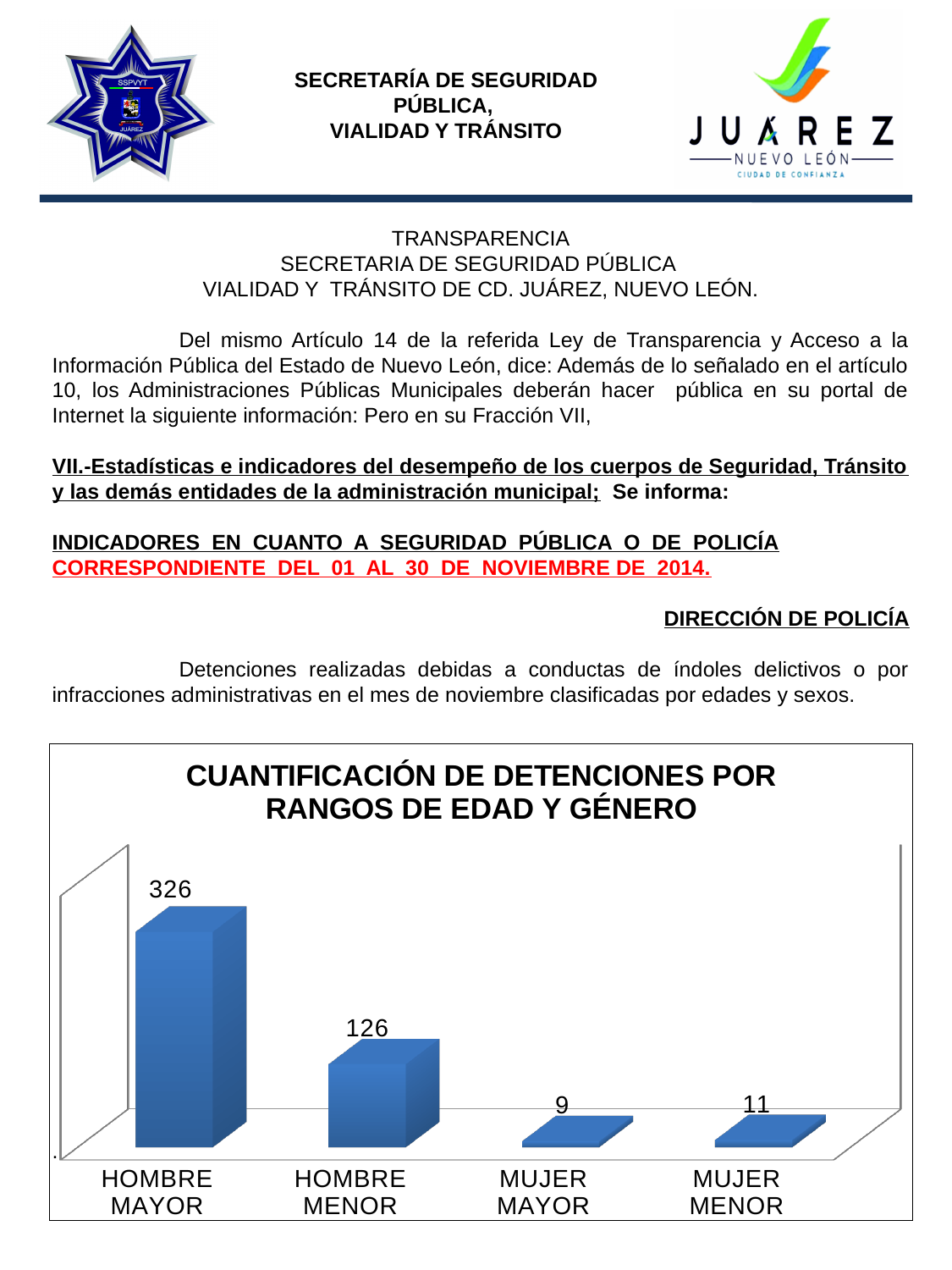
What is the value for HOMBRE MENOR? 126 What is the value for MUJER MENOR? 11 Which category has the highest value? HOMBRE MAYOR Which category has the lowest value? MUJER MAYOR What is the value for MUJER MAYOR? 9 What is the difference between the values for MUJER MENOR and MUJER MAYOR? 2 What kind of chart is shown on the slide? bar chart What is the title of the chart? CUANTIFICACIÓN DE DETENCIONES POR RANGOS DE EDAD Y GÉNERO Which is larger, the value for HOMBRE MENOR or the value for MUJER MENOR? HOMBRE MENOR How many categories are shown in the chart? 4 What is the value for HOMBRE MAYOR? 326 What is the difference between the values for HOMBRE MAYOR and HOMBRE MENOR? 200